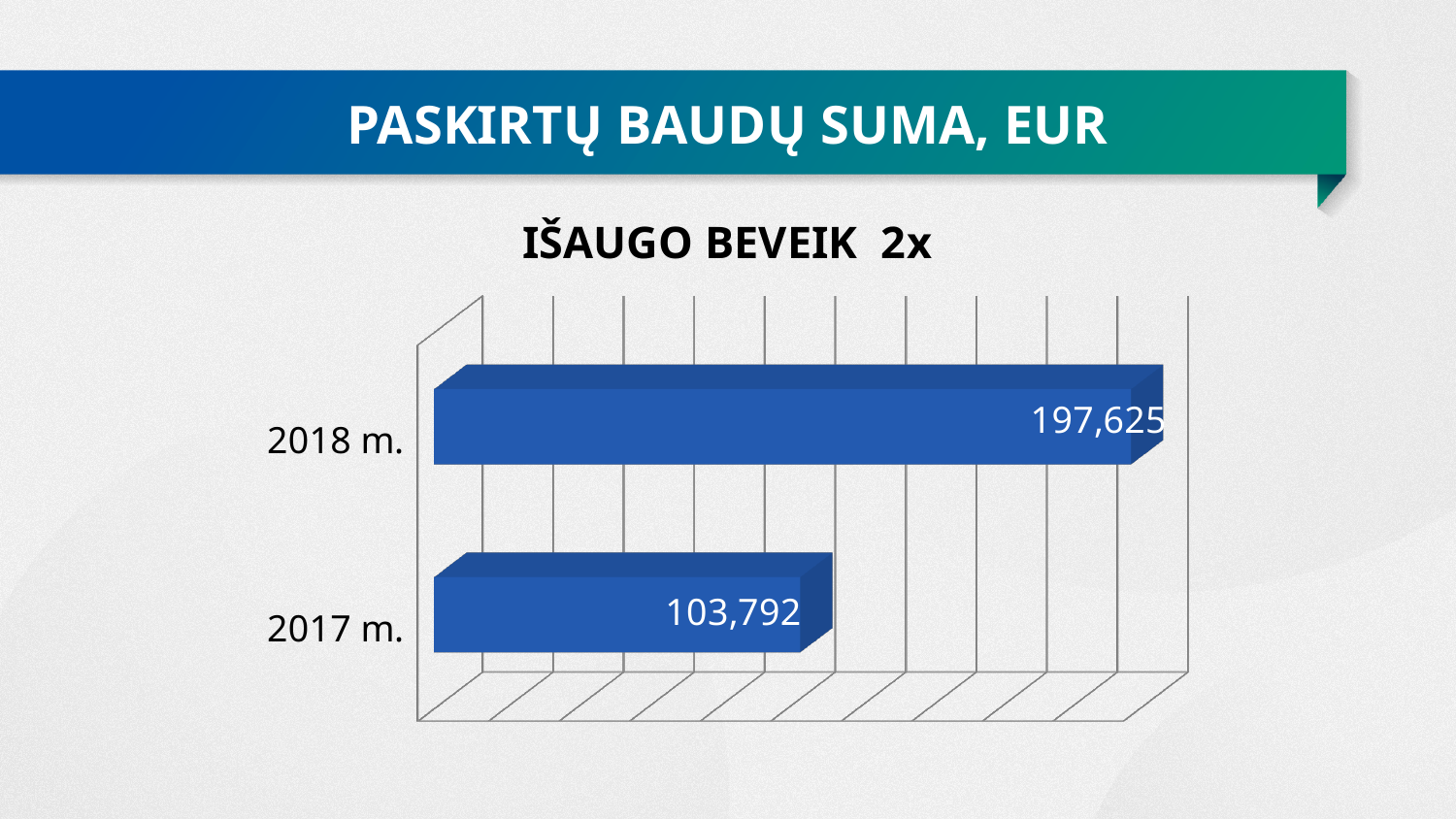
Which year has the lowest value? 2017 m. What is the value for 2018 m.? 197,625 What kind of chart is shown on the slide? Bar chart What is the difference between the values for 2018 m. and 2017 m.? 93,833 What is the title of the slide? PASKIRTŲ BAUDŲ SUMA, EUR How many categories are shown in the chart? 2 Which is larger, the value for 2017 m. or the value for 2018 m.? 2018 m. What text appears directly above the chart? IŠAUGO BEVEIK 2x Which year has the highest value? 2018 m. What is the value for 2017 m.? 103,792 Did the value rise or fall from 2017 m. to 2018 m.? Rise